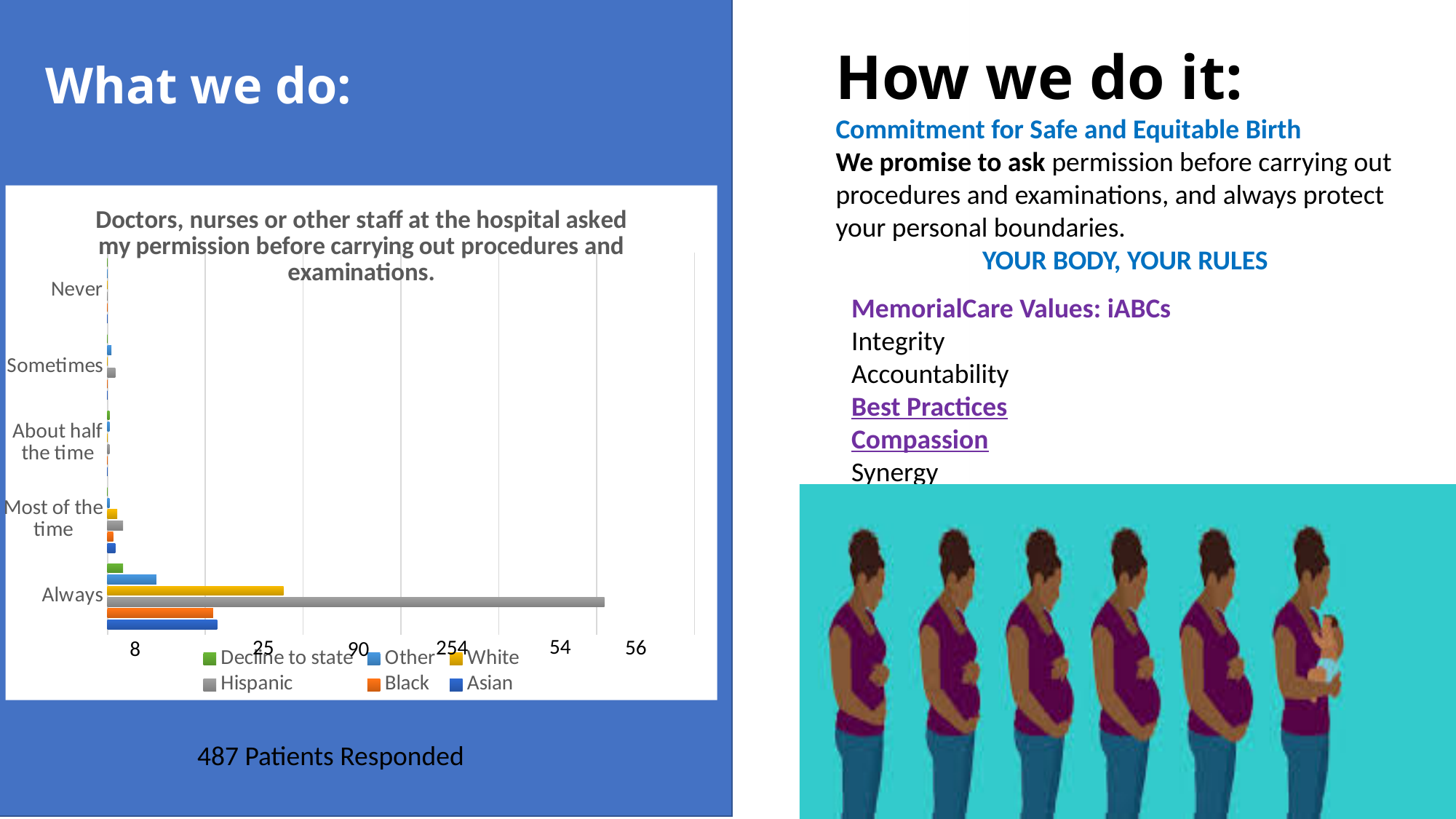
Which series has the longest bar in the 'Always' category? Hispanic How many series does the chart's legend list? 6 Which response category shows no visible bars at all? Never In the 'Most of the time' category, which bar is longer: Hispanic or Other? Hispanic In the 'Always' category, which bar is longer: White or Other? White In the 'Always' category, which bar is shorter: Decline to state or Asian? Decline to state How many response categories are listed on the vertical axis of the chart? 5 Which response category has the longest bars overall? Always Which series is shown in green in the chart's legend? Decline to state What colour represents the Hispanic series in the chart? Gray What kind of chart is shown on the slide? Bar chart